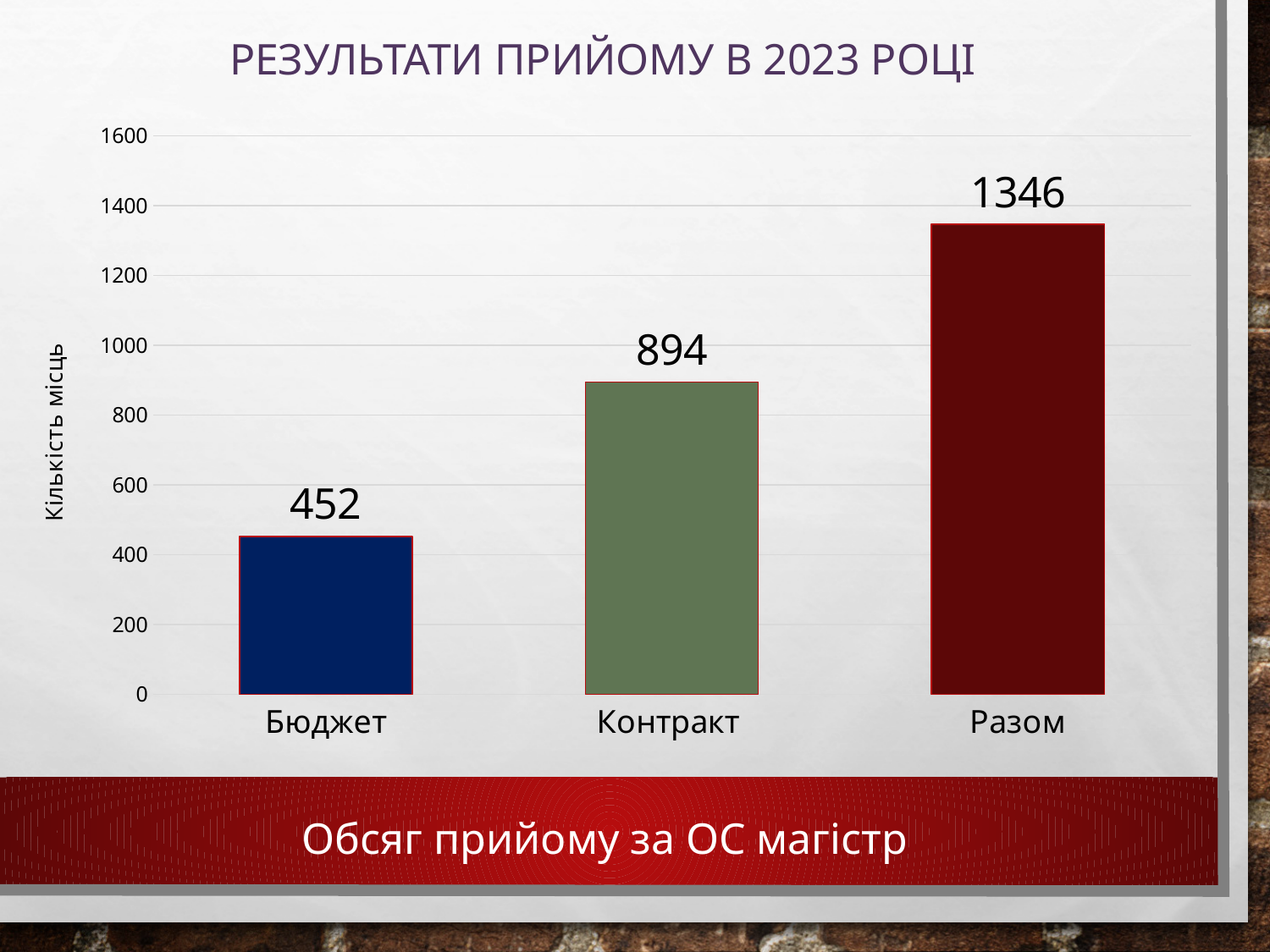
What is the label of the vertical axis? Кількість місць Is the value for Контракт greater or less than 1000? less How many categories are shown on the x axis? 3 What is the difference between the values for Контракт and Бюджет? 442 What is the value for Бюджет? 452 Which is larger, the value for Бюджет or the value for Контракт? Контракт What is the value for Контракт? 894 Do the values rise or fall from left to right along the x axis? rise Which category has the highest value? Разом What kind of chart is shown on the slide? bar chart Which category has the lowest value? Бюджет What is the value for Разом? 1346